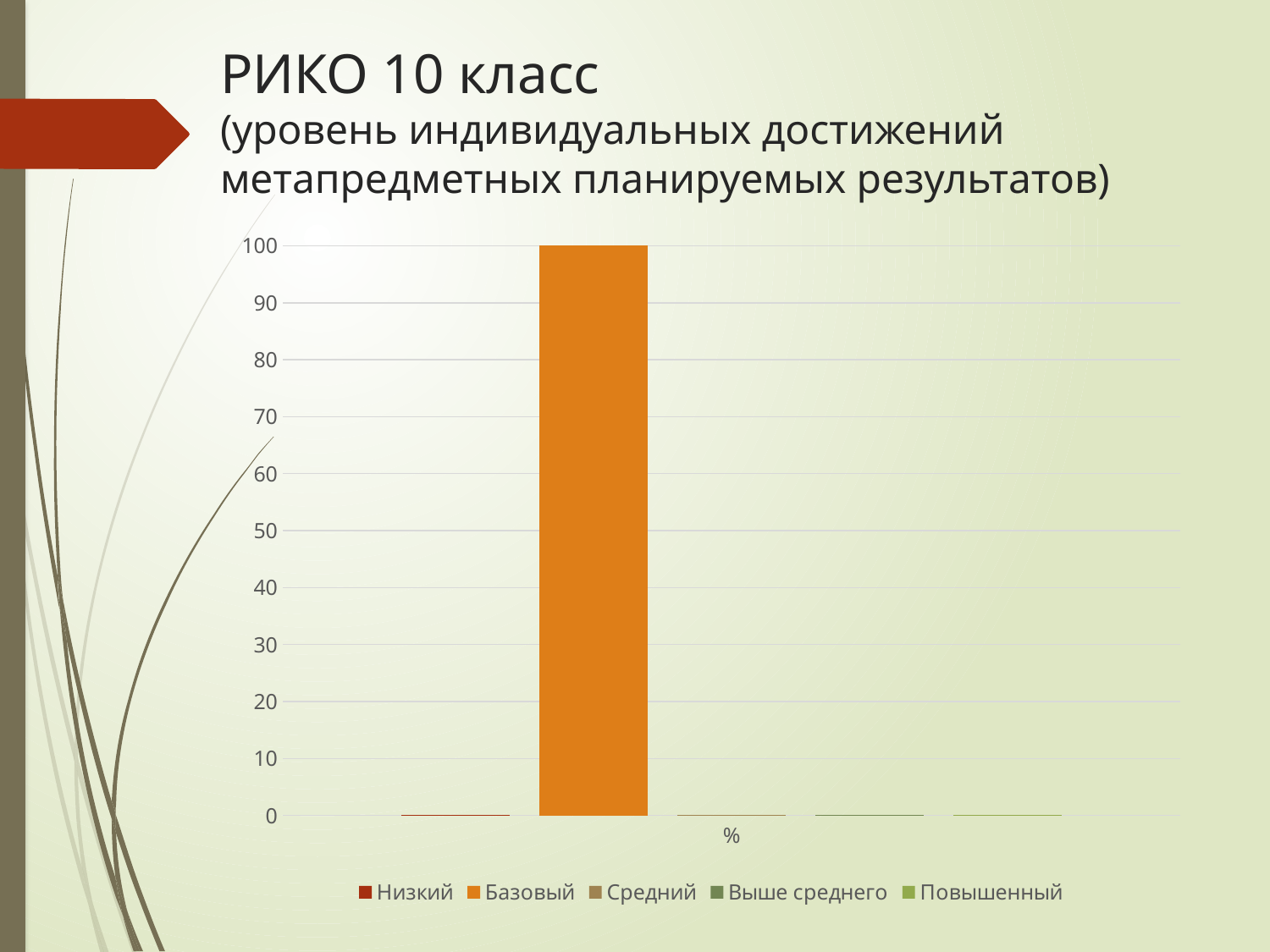
What colour is the bar for the Базовый series? orange How many series does the legend list? 5 Which series has the highest value? Базовый What is the category label shown on the x axis? % What is the value for the Базовый series? 100 How many categories are shown on the x axis? 1 Which is larger, the value for Базовый or the value for Средний? Базовый Is the value for Базовый greater or less than 50? greater What kind of chart is shown on the slide? bar chart